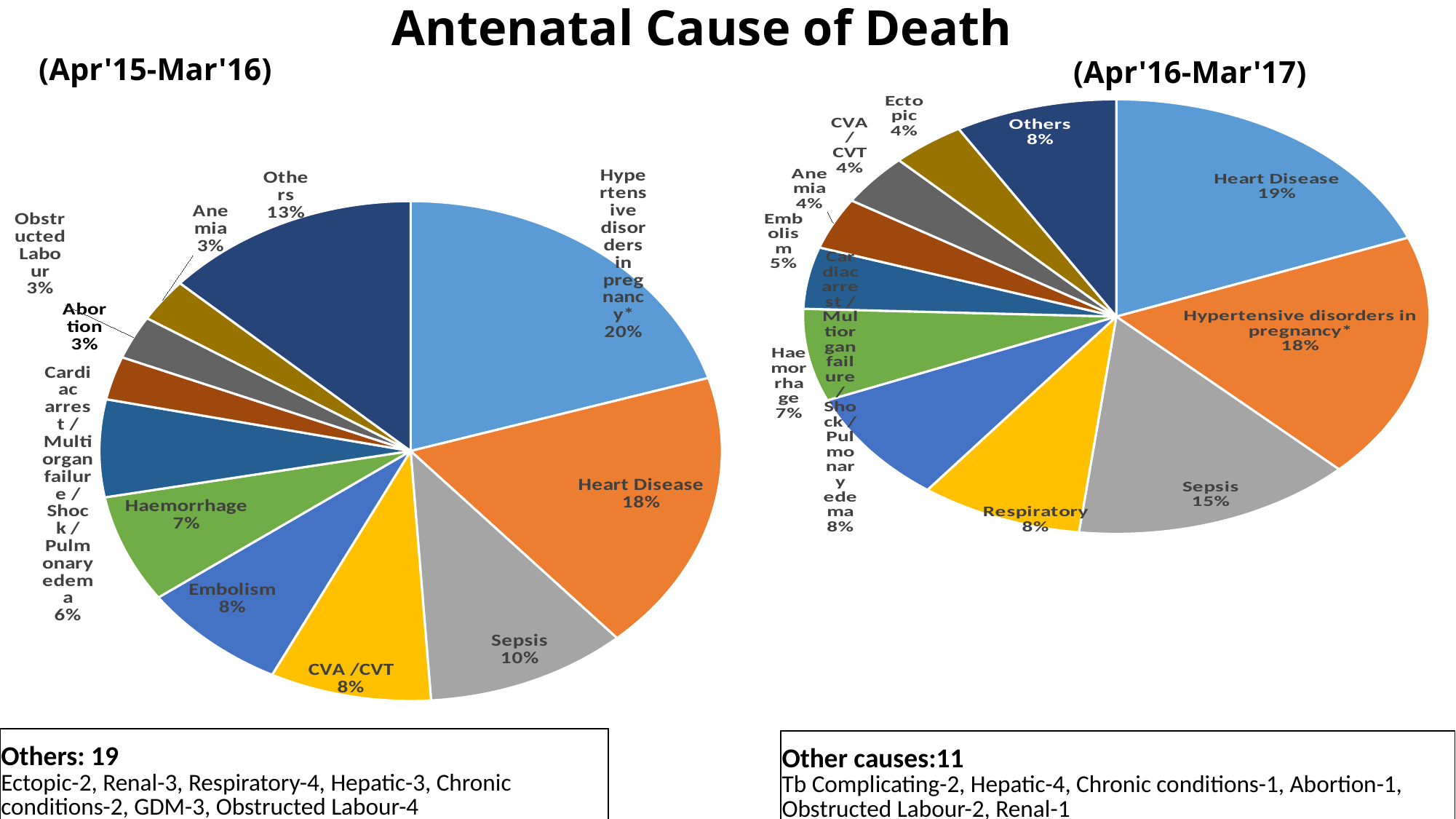
In the Apr'16-Mar'17 chart, what is the difference between Sepsis and Respiratory? 7% In the Apr'15-Mar'16 chart, which is larger, Others or Sepsis? Others In the Apr'15-Mar'16 chart, what share is Sepsis? 10% In the Apr'15-Mar'16 chart, what share is Hypertensive disorders in pregnancy? 20% In the Apr'16-Mar'17 chart, what share is Sepsis? 15% What type of charts are shown on the slide? Pie charts What is the title of the slide? Antenatal Cause of Death How many slices does the Apr'15-Mar'16 pie chart have? 11 In the Apr'15-Mar'16 chart, what is the difference between Heart Disease and Haemorrhage? 11% In the Apr'15-Mar'16 chart, which cause has the largest share? Hypertensive disorders in pregnancy In the Apr'16-Mar'17 chart, which cause has the largest share? Heart Disease